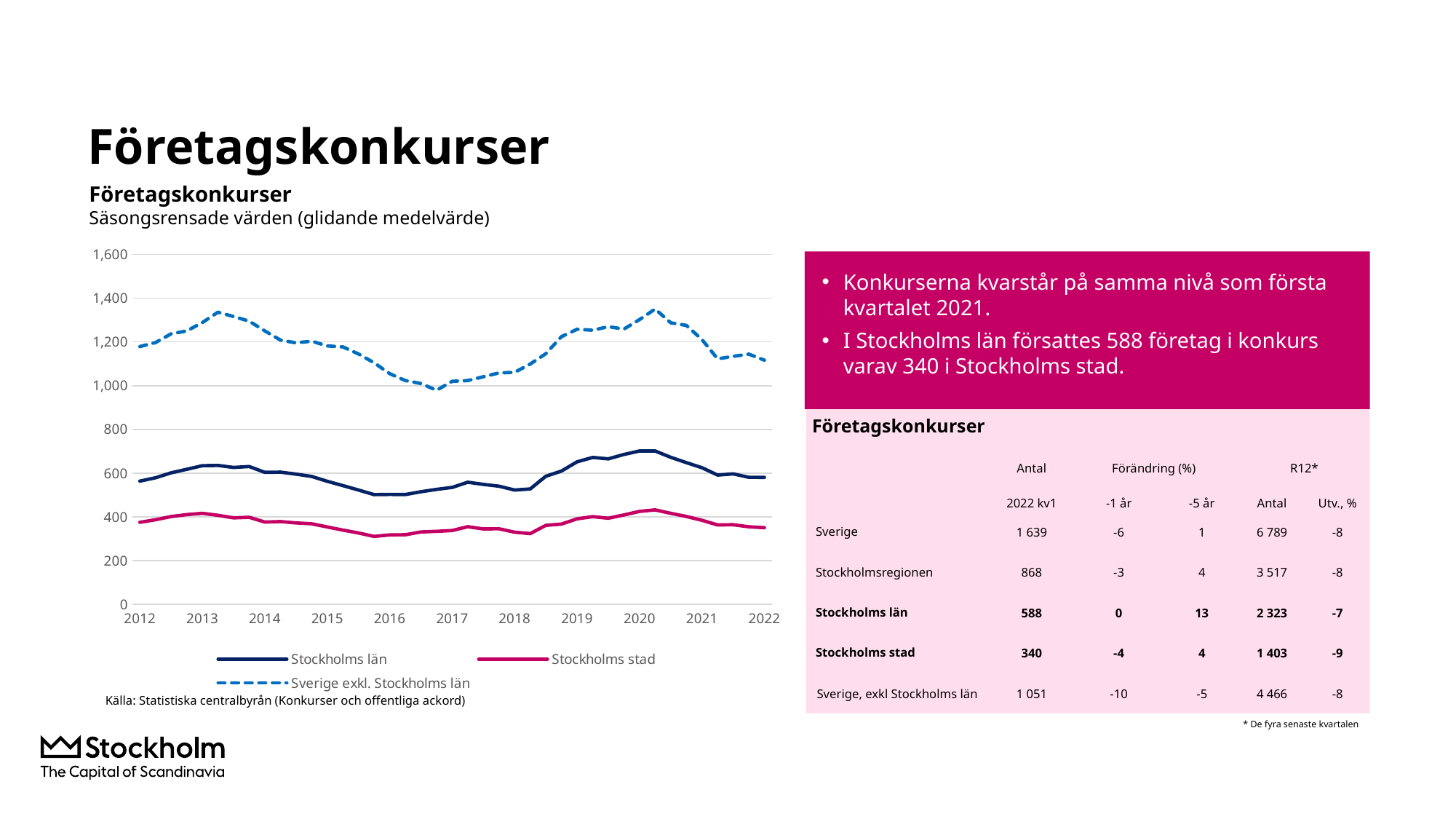
Which series in the chart is drawn with a dashed line? Sverige exkl. Stockholms län Does the Sverige exkl. Stockholms län series rise or fall between 2013 and 2017? fall What kind of chart is shown on the slide? line chart Which series in the chart has the highest values throughout the period? Sverige exkl. Stockholms län Does the Stockholms län series rise or fall between 2018 and 2020? rise How many series does the chart legend list? 3 In 2022, which is larger: the value for Stockholms län or the value for Stockholms stad? Stockholms län How many year labels are shown on the x axis of the chart? 11 Which series in the chart has the lowest values throughout the period? Stockholms stad Is the peak value for Sverige exkl. Stockholms län around 2020 greater or less than 1,200? greater Is the value for Stockholms län in 2012 greater or less than 600? less Is the value for Stockholms stad in 2016 greater or less than 400? less